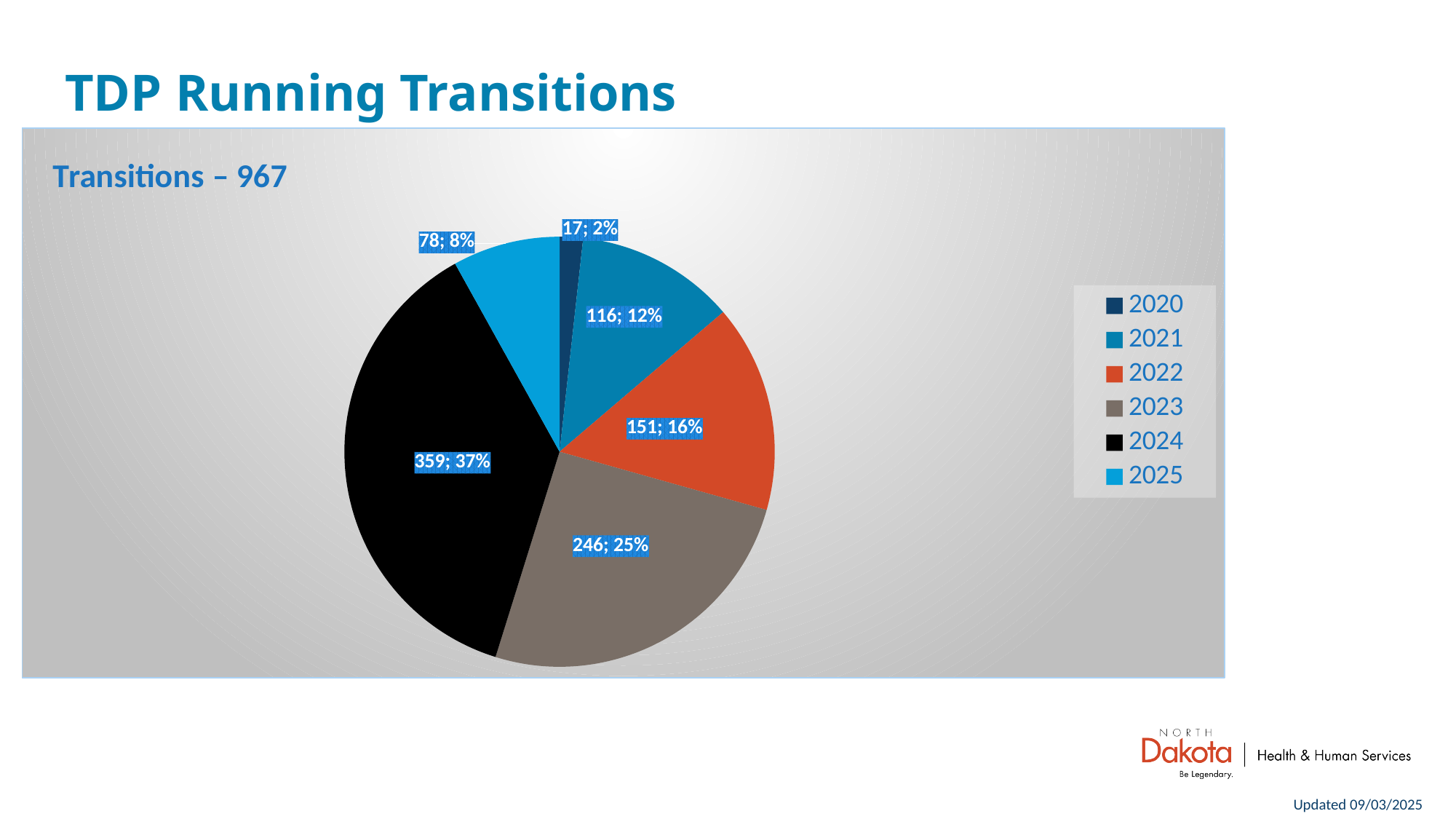
What is the difference in transitions between 2024 and 2023? 113 What share of the pie does 2023 represent? 25% Which year has the smallest slice of the pie? 2020 Which year is represented by the black slice? 2024 Which year has the largest slice of the pie? 2024 Which year has more transitions, 2021 or 2025? 2021 What total number of transitions is stated in the chart title? 967 What type of chart is shown on the slide? Pie chart How many transitions are shown for 2022? 151 How many transitions are shown for 2024? 359 How many years are listed in the legend? 6 What share of the pie does 2020 represent? 2%